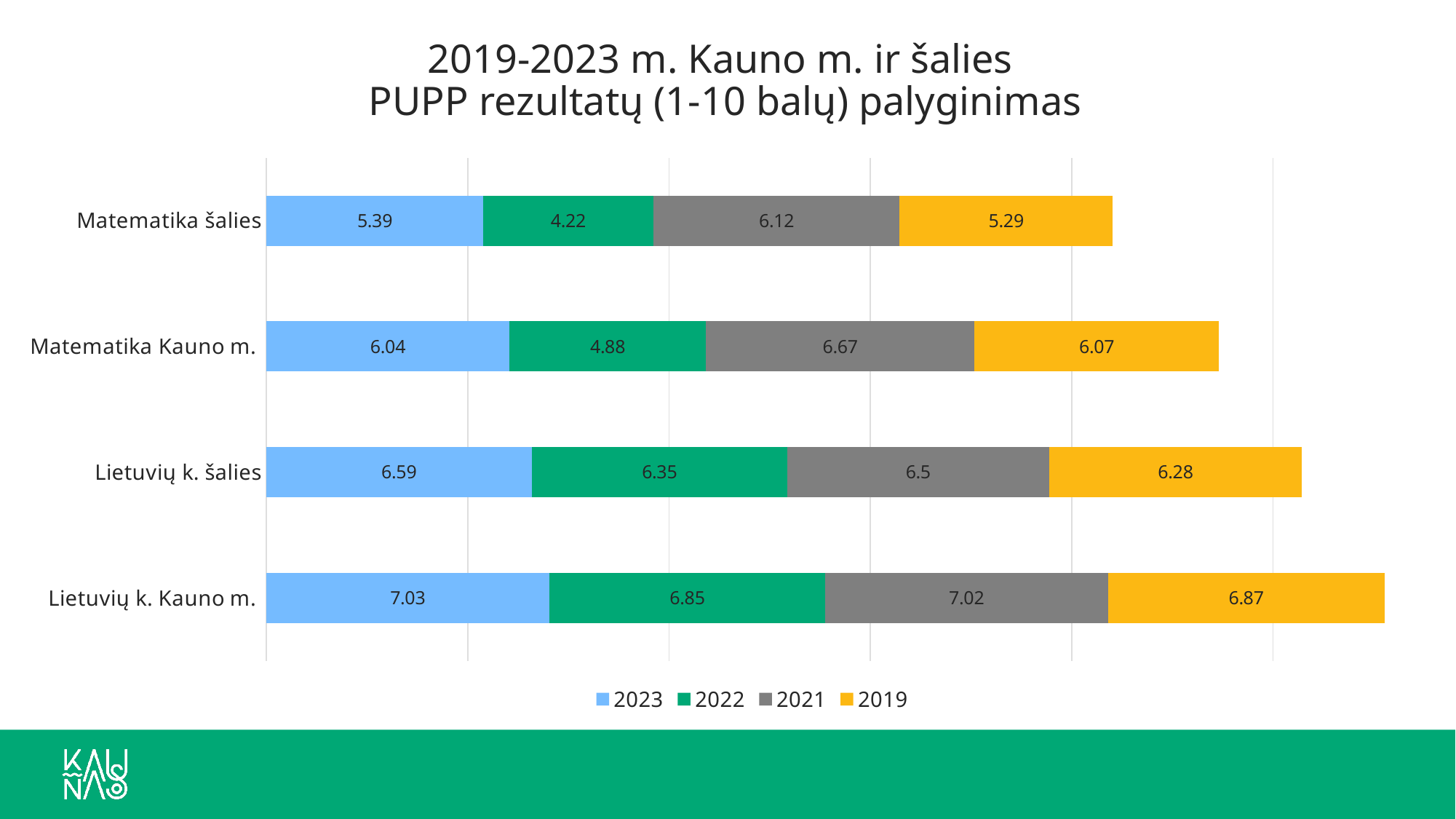
Which year does the yellow segment represent according to the legend? 2019 What is the total of the stacked bar for Matematika šalies? 21.02 Which is larger: the 2021 value for Matematika Kauno m. or the 2021 value for Matematika šalies? Matematika Kauno m. What kind of chart is shown on the slide? Stacked bar chart What is the 2019 value for Matematika šalies? 5.29 What is the 2023 value for Matematika Kauno m.? 6.04 Which category has the highest 2022 value? Lietuvių k. Kauno m. How many categories are shown on the chart? 4 Which category has the lowest 2023 value? Matematika šalies What is the 2021 value for Lietuvių k. šalies? 6.5 How many series does the legend list? 4 What is the difference between the 2023 values for Lietuvių k. Kauno m. and Lietuvių k. šalies? 0.44